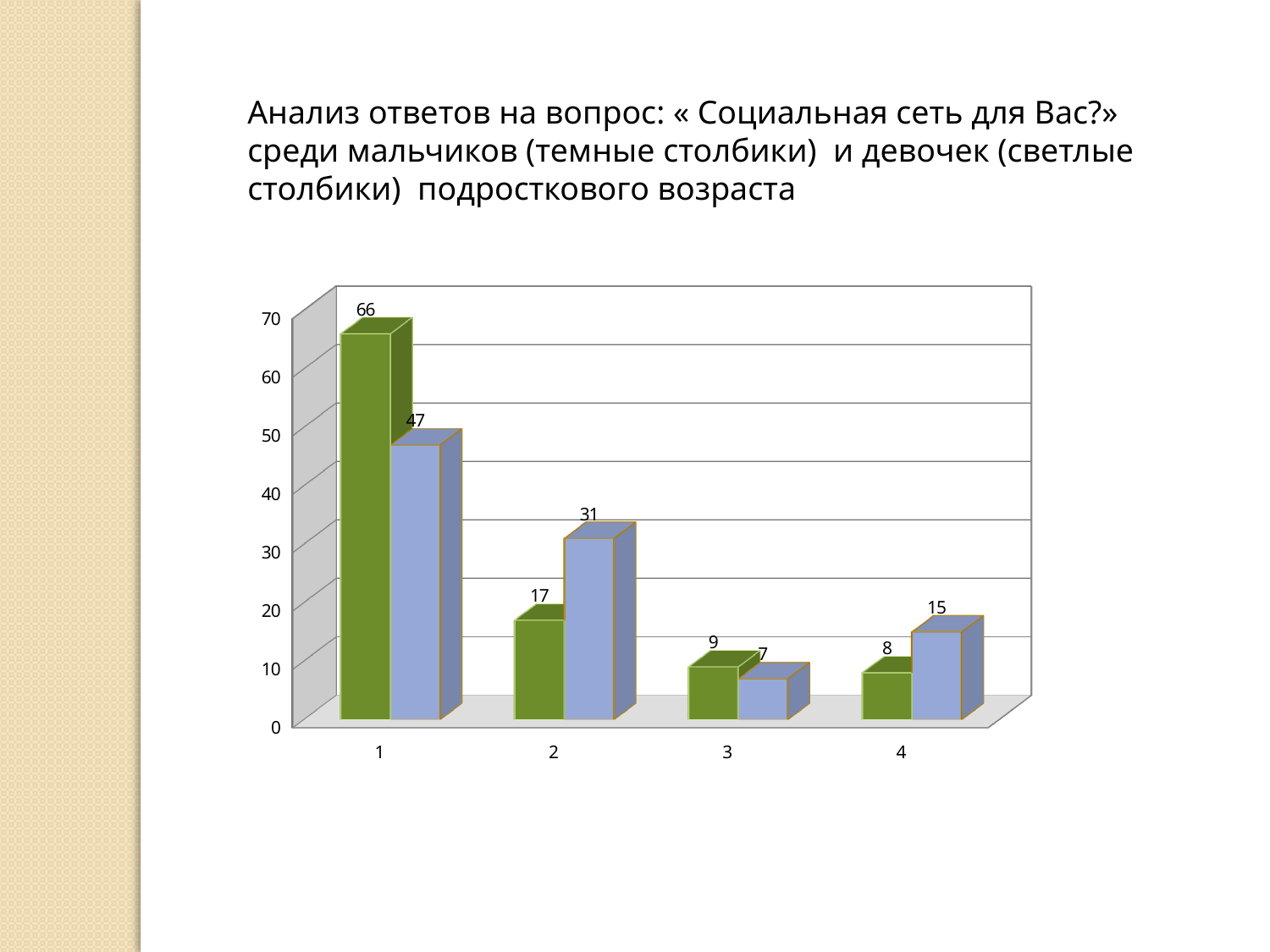
For category 3, which bar is larger, the dark or the light one? dark What is the value of the light bar for category 4? 15 What is the difference between the light and dark bars for category 2? 14 What is the value of the light bar for category 2? 31 Which category has the lowest light bar? 3 According to the slide text, which group do the dark bars represent? boys (мальчики) Which category has the highest dark bar? 1 For category 4, which bar is larger, the dark or the light one? light How many categories are shown on the x axis? 4 What is the value of the dark bar for category 1? 66 What kind of chart is shown on the slide? bar chart What is the difference between the dark and light bars for category 1? 19